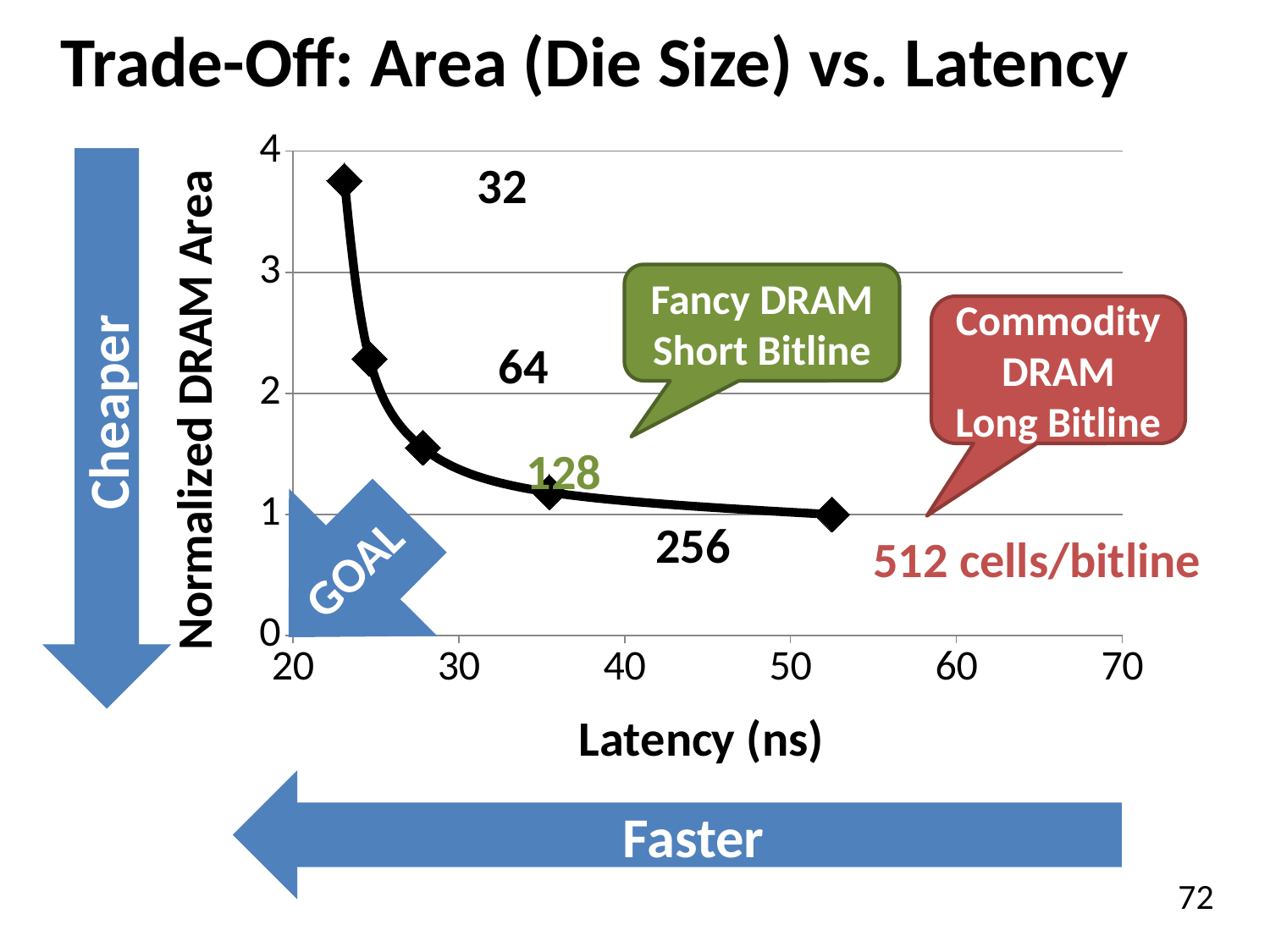
What is the normalized DRAM area for the 512 cells/bitline point? 1 Which labeled point has the highest normalized DRAM area? 32 What is the label of the x axis? Latency (ns) Which labeled point has the lowest normalized DRAM area? 512 cells/bitline How many data points are plotted on the curve? 5 As latency increases along the x axis, does the normalized DRAM area rise or fall? fall Is the normalized DRAM area for the point labeled 64 greater or less than 2? greater Is the normalized DRAM area for the point labeled 32 greater or less than 3? greater What kind of chart is shown on the slide? line chart Is the latency for the 512 cells/bitline point greater or less than 50? greater What is the title of the chart on the slide? Trade-Off: Area (Die Size) vs. Latency Which has a larger normalized DRAM area, the point labeled 32 or the point labeled 64? 32